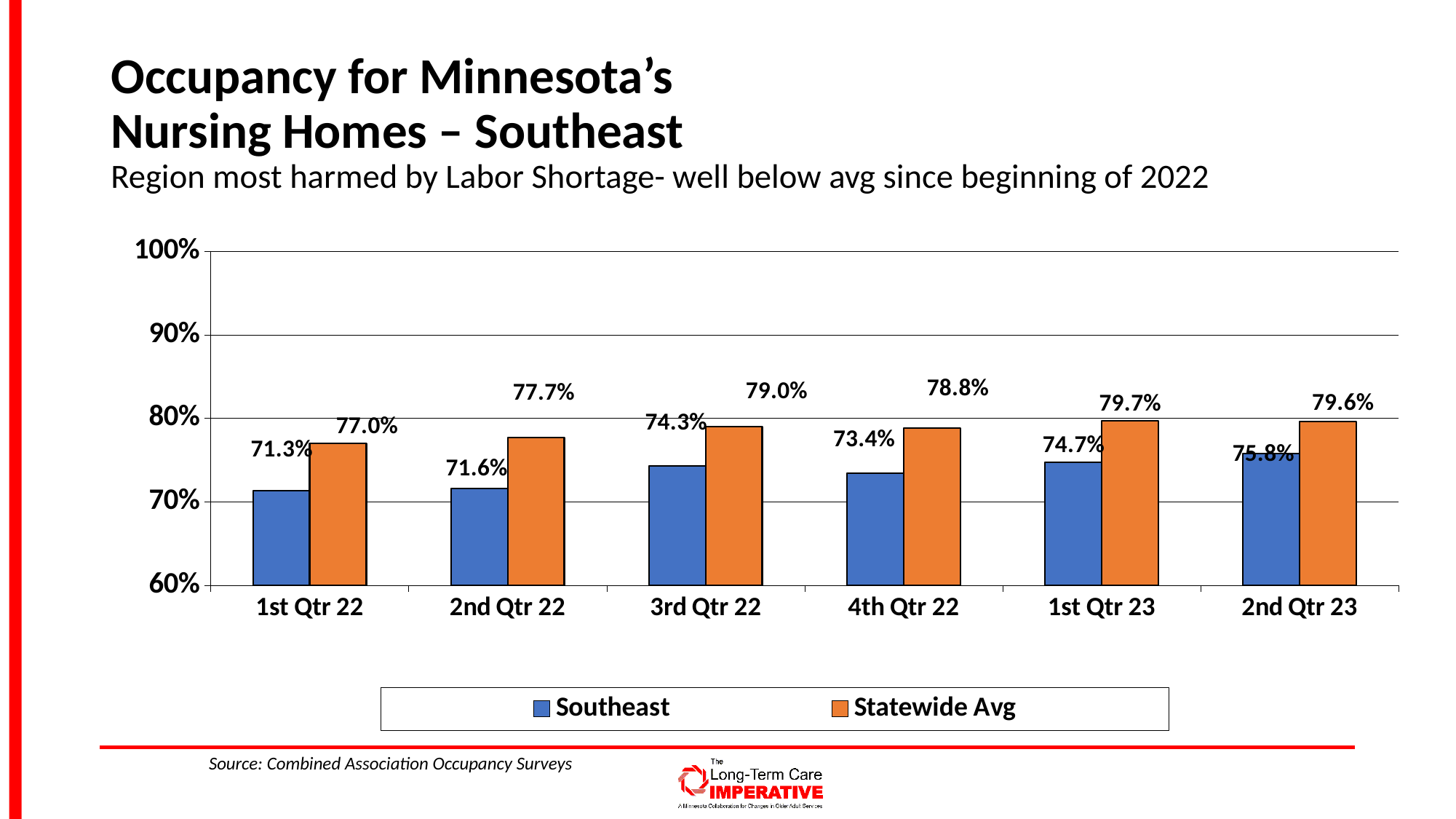
Is the Southeast occupancy value for 3rd Qtr 22 greater or less than 80%? less What is the Statewide Avg occupancy value for 3rd Qtr 22? 79.0% In which quarter is the Statewide Avg occupancy highest? 1st Qtr 23 Which colour represents the Statewide Avg series? orange What is the difference between the Statewide Avg and Southeast occupancy in 4th Qtr 22? 5.4% How many series does the legend list? 2 How many quarters are shown on the x axis? 6 What is the Southeast occupancy value for 1st Qtr 22? 71.3% What is the Southeast occupancy value for 2nd Qtr 23? 75.8% In which quarter is the Southeast occupancy lowest? 1st Qtr 22 What kind of chart is shown on the slide? bar chart Which is larger in 2nd Qtr 22: the Southeast value or the Statewide Avg value? Statewide Avg